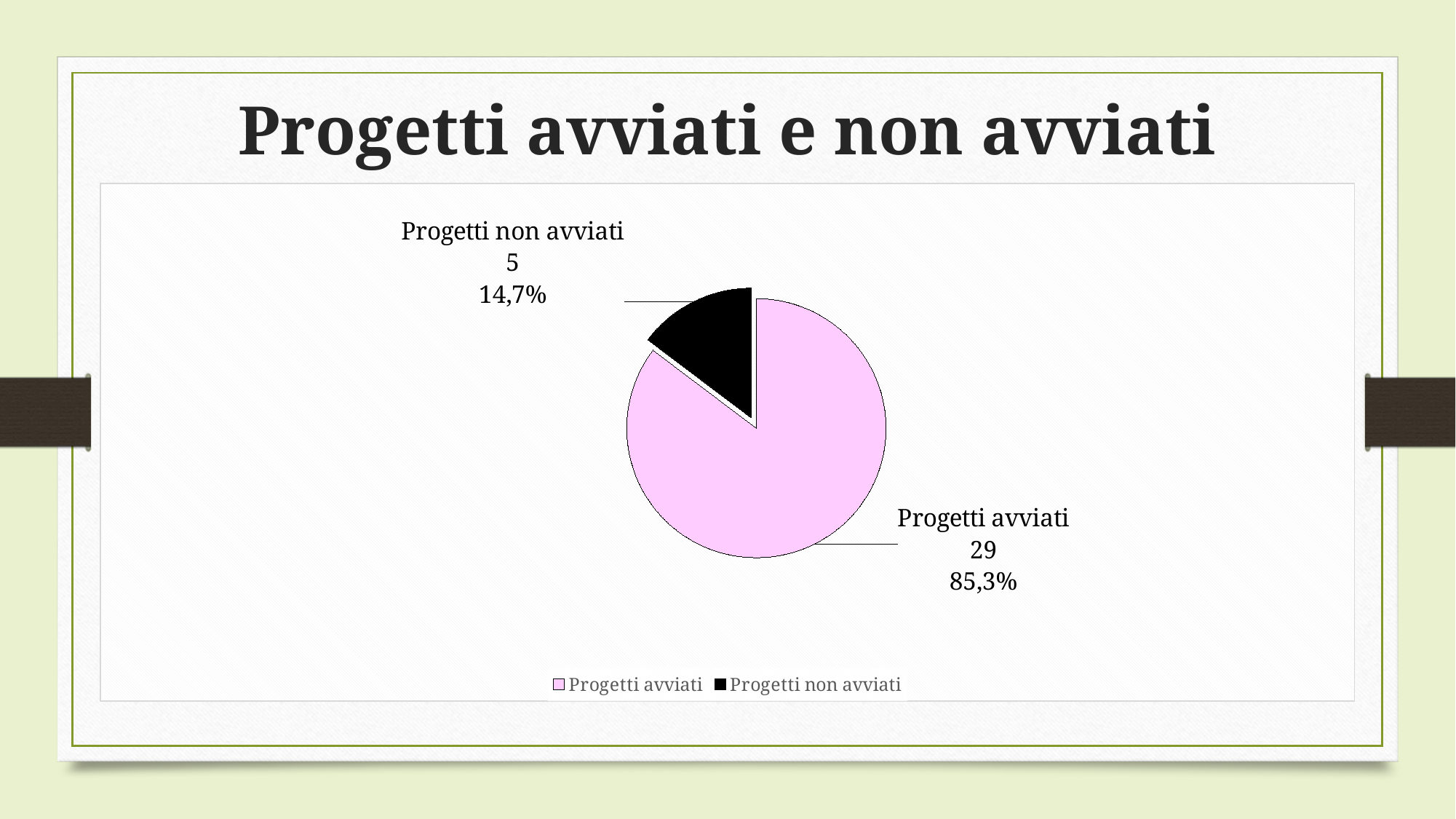
How many projects are shown as 'Progetti avviati'? 29 What is the total number of projects shown in the pie chart? 34 What kind of chart is shown on the slide? pie chart What share of the pie does 'Progetti avviati' represent? 85,3% How many slices does the pie chart have? 2 What is the difference between the number of 'Progetti avviati' and 'Progetti non avviati'? 24 Which is larger, 'Progetti avviati' or 'Progetti non avviati'? Progetti avviati Which slice is the smallest in the pie chart? Progetti non avviati How many projects are shown as 'Progetti non avviati'? 5 Which slice is the largest in the pie chart? Progetti avviati What share of the pie does 'Progetti non avviati' represent? 14,7% What colour is the 'Progetti non avviati' slice? black